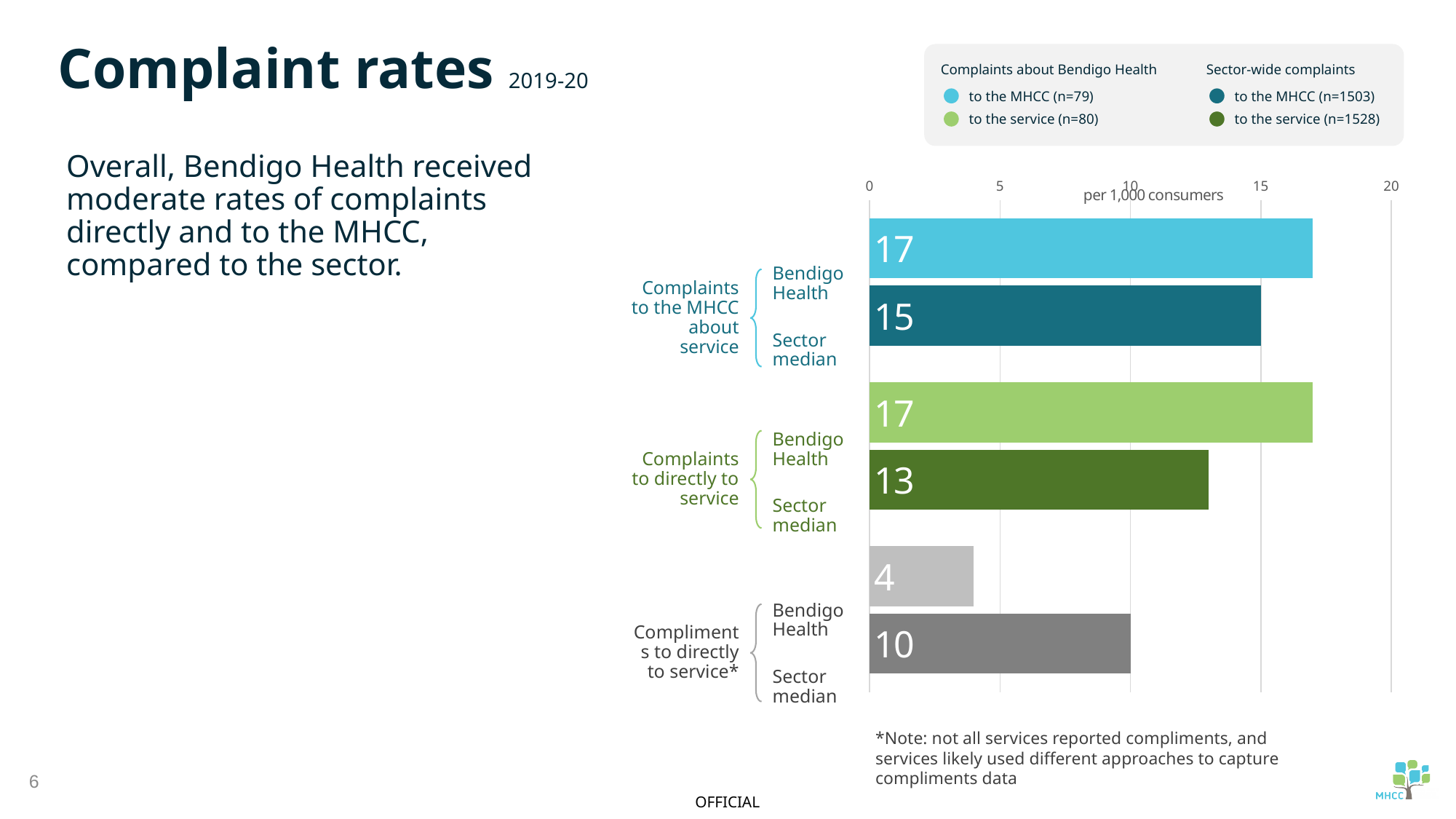
What unit is shown on the chart's axis? per 1,000 consumers Which bar has the lowest value on the chart? Bendigo Health, compliments directly to service What is the sector median for complaints directly to service? 13 What is the value for Bendigo Health for compliments directly to service? 4 Which is larger for complaints to the MHCC about service: Bendigo Health or the sector median? Bendigo Health What is the sector median for complaints to the MHCC about service? 15 What type of chart is shown on the slide? Bar chart What is the value for Bendigo Health for complaints to the MHCC about service? 17 What is the sector median for compliments directly to service? 10 What is the value for Bendigo Health for complaints directly to service? 17 What is the difference between the sector median and Bendigo Health for compliments directly to service? 6 What is the difference between Bendigo Health and the sector median for complaints directly to service? 4